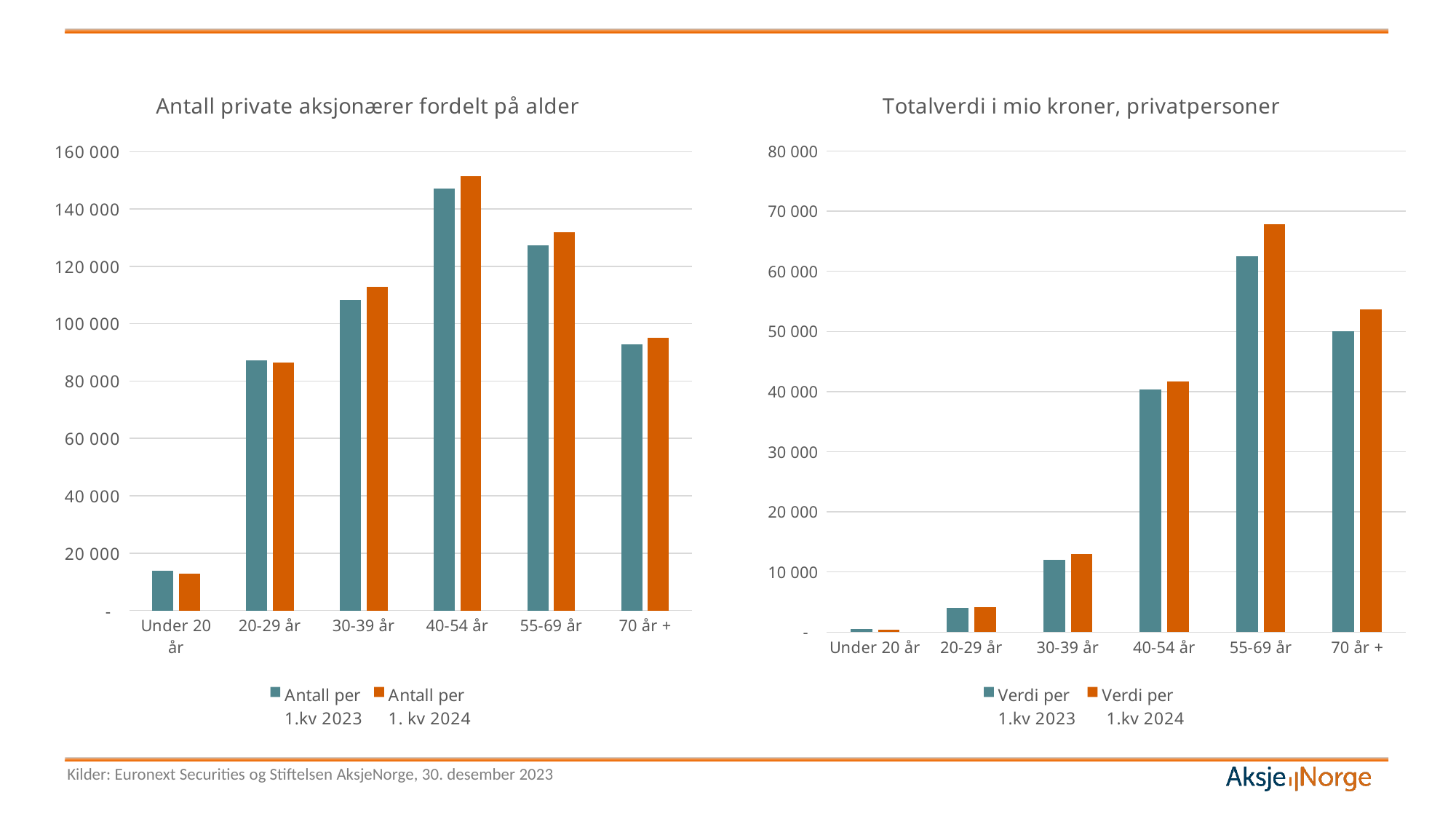
How many series does the legend of the right chart 'Totalverdi i mio kroner, privatpersoner' list? 2 In the left chart 'Antall private aksjonærer fordelt på alder', is the value for Under 20 år in 'Antall per 1.kv 2023' greater or less than 20 000? less What type of chart is the left chart, 'Antall private aksjonærer fordelt på alder'? bar chart How many age groups are shown on the x axis of the right chart 'Totalverdi i mio kroner, privatpersoner'? 6 In the right chart 'Totalverdi i mio kroner, privatpersoner', for 70 år +, which series is larger: 'Verdi per 1.kv 2023' or 'Verdi per 1.kv 2024'? Verdi per 1.kv 2024 In the right chart 'Totalverdi i mio kroner, privatpersoner', which age group has the highest total value? 55-69 år In the left chart 'Antall private aksjonærer fordelt på alder', which age group has the highest number of shareholders? 40-54 år In the left chart 'Antall private aksjonærer fordelt på alder', which age group has the lowest number of shareholders? Under 20 år In the right chart 'Totalverdi i mio kroner, privatpersoner', is the value for 55-69 år in 'Verdi per 1.kv 2024' greater or less than 60 000? greater In the left chart 'Antall private aksjonærer fordelt på alder', for 55-69 år, which series is larger: 'Antall per 1.kv 2023' or 'Antall per 1. kv 2024'? Antall per 1. kv 2024 In the left chart 'Antall private aksjonærer fordelt på alder', is the value for 40-54 år in 'Antall per 1. kv 2024' greater or less than 140 000? greater